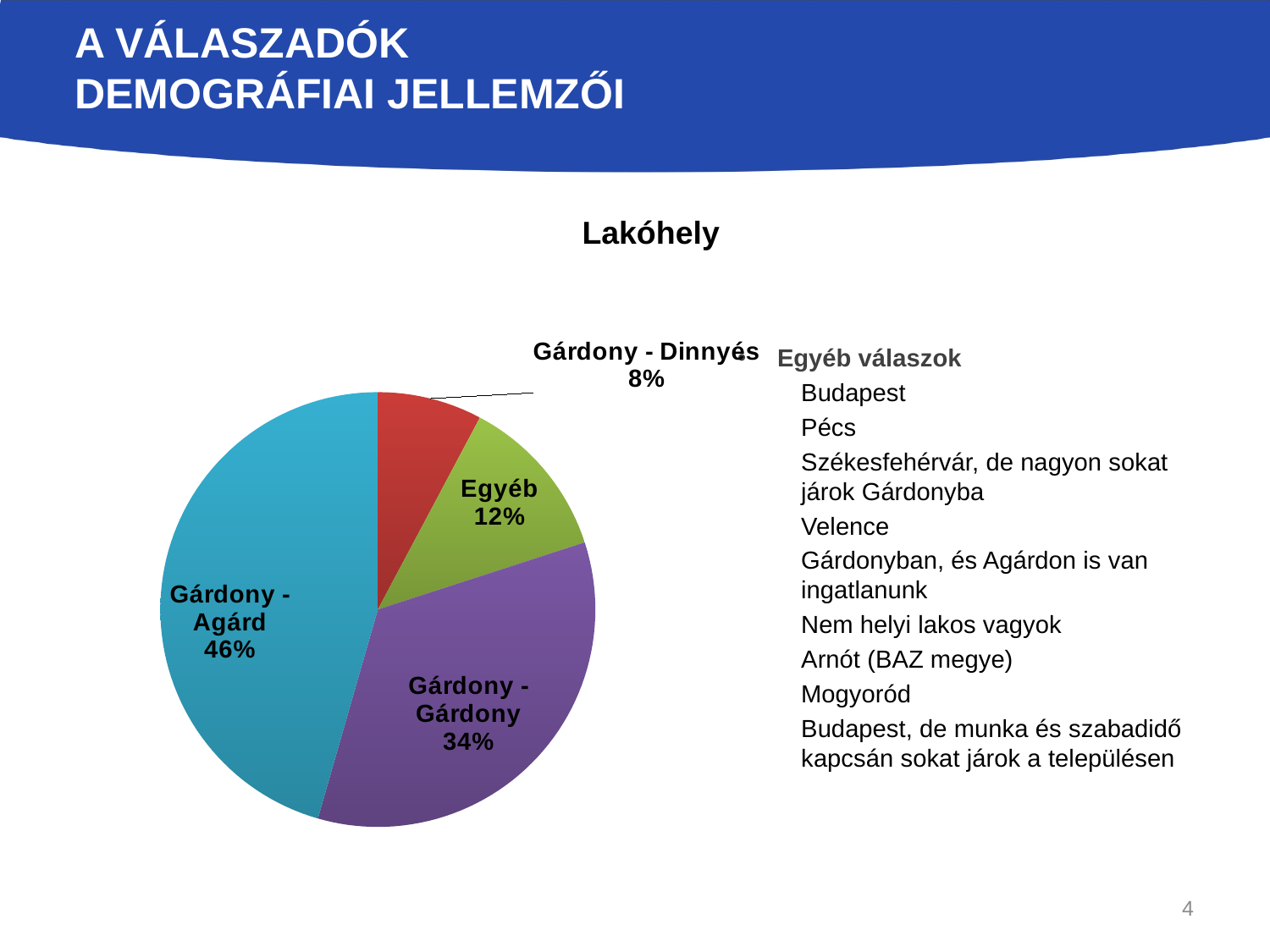
What colour is the "Gárdony - Agárd" slice? blue How many slices does the pie chart have? 4 Which category has the smallest slice of the pie? Gárdony - Dinnyés Which is larger, the share for "Egyéb" or the share for "Gárdony - Dinnyés"? Egyéb Which category has the largest slice of the pie? Gárdony - Agárd What share of the pie does "Egyéb" have? 12% What is the difference in percentage points between "Gárdony - Agárd" and "Gárdony - Gárdony"? 12 What is the title of the chart? Lakóhely What share of the pie does "Gárdony - Dinnyés" have? 8% What share of the pie does "Gárdony - Agárd" have? 46% What kind of chart is shown under the title "Lakóhely"? pie chart